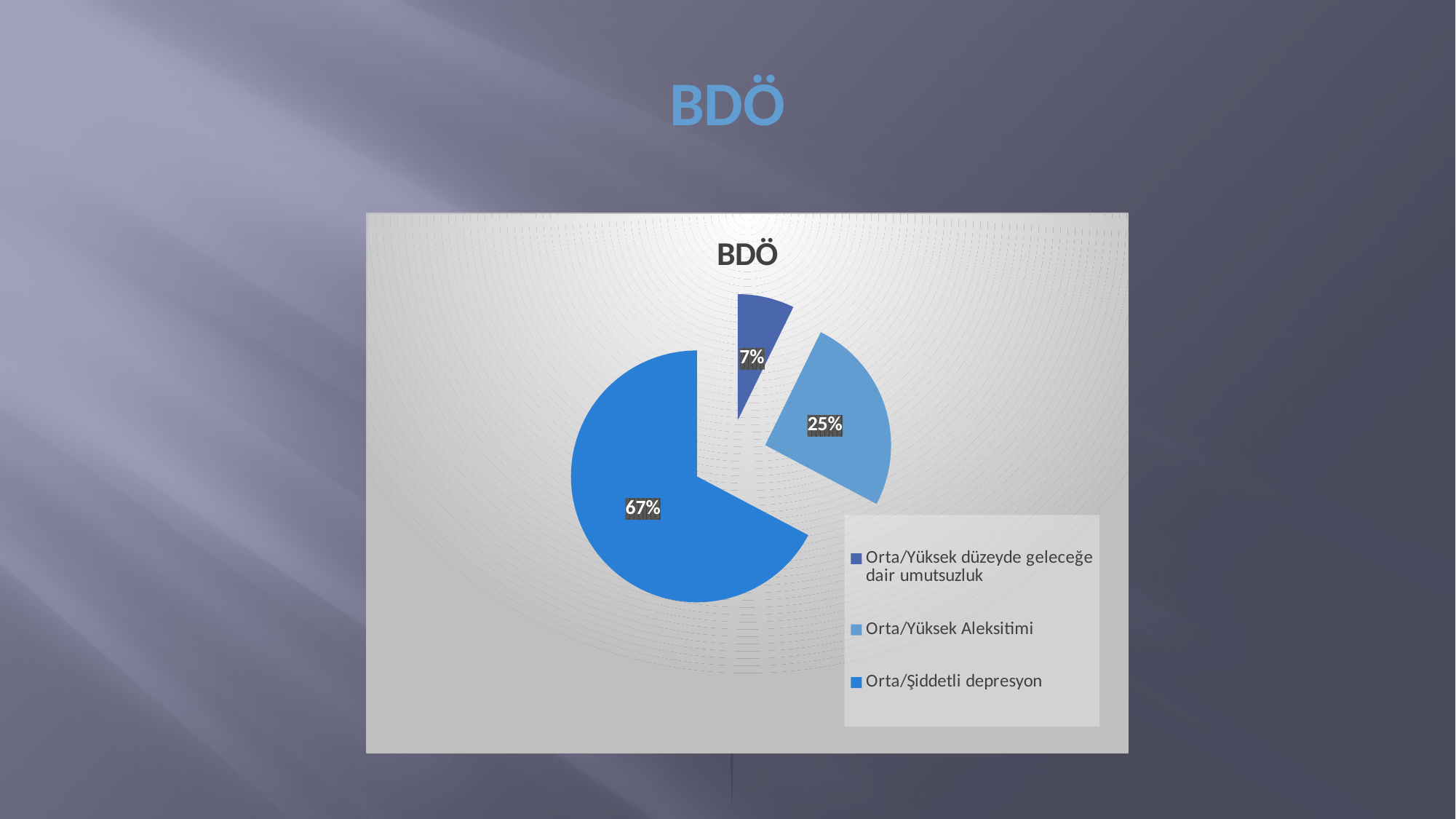
How many entries does the legend list? 3 What kind of chart is shown on the slide? pie chart What share of the pie does Orta/Yüksek düzeyde geleceğe dair umutsuzluk take? 7% What is the difference between the shares of Orta/Yüksek Aleksitimi and Orta/Yüksek düzeyde geleceğe dair umutsuzluk? 18% Which category has the smallest slice of the pie? Orta/Yüksek düzeyde geleceğe dair umutsuzluk What is the title of the chart? BDÖ What share of the pie does Orta/Yüksek Aleksitimi take? 25% Which is larger, the share for Orta/Yüksek Aleksitimi or the share for Orta/Yüksek düzeyde geleceğe dair umutsuzluk? Orta/Yüksek Aleksitimi Which category has the largest slice of the pie? Orta/Şiddetli depresyon How many slices does the pie chart have? 3 What share of the pie does Orta/Şiddetli depresyon take? 67% What is the difference between the shares of Orta/Şiddetli depresyon and Orta/Yüksek Aleksitimi? 42%